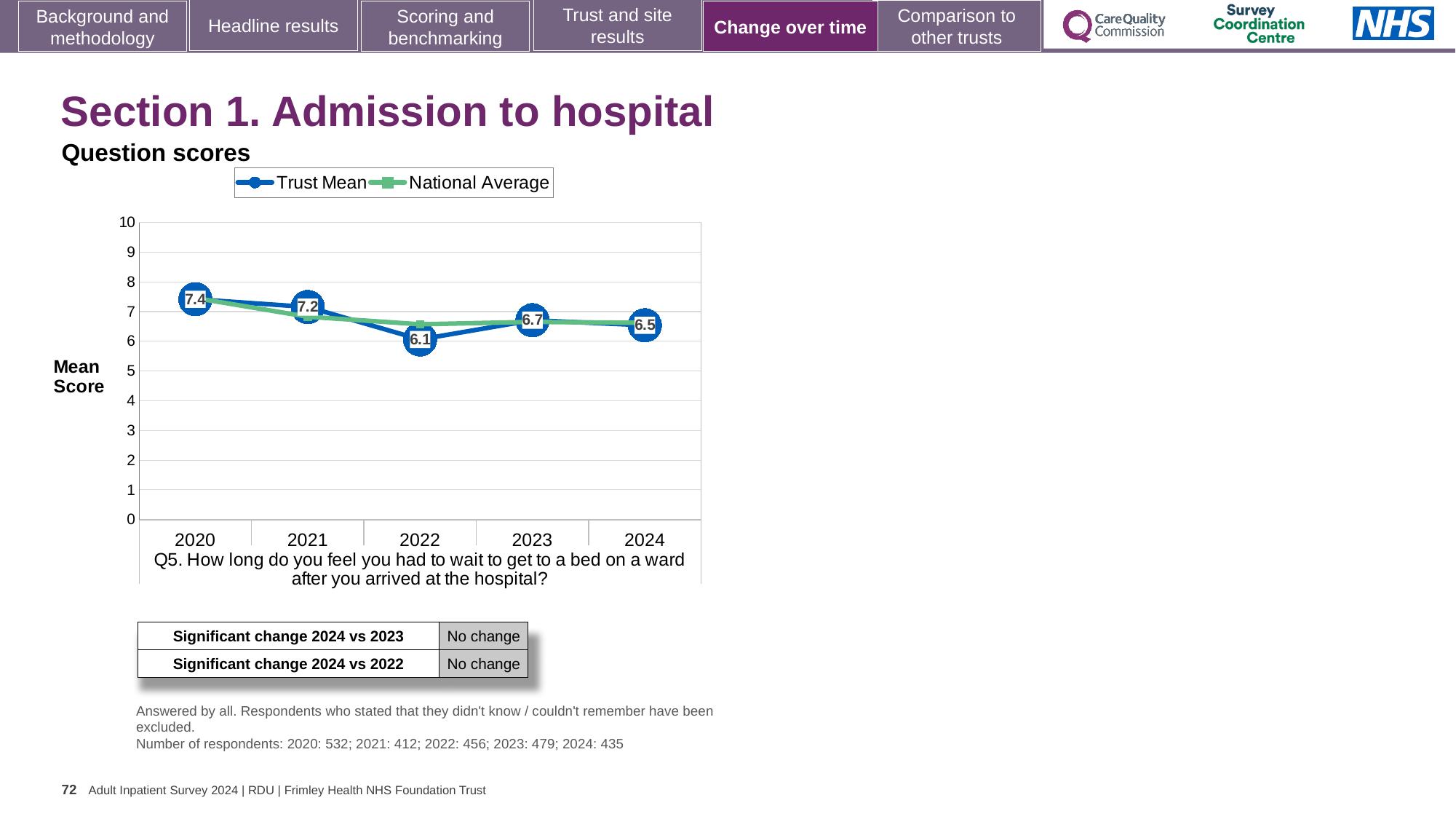
What kind of chart is shown on the slide? Line chart What is the difference between the Trust Mean scores for 2020 and 2022? 1.3 What is the Trust Mean score for 2024? 6.5 What is the Trust Mean score for 2020? 7.4 What is the Trust Mean score for 2022? 6.1 Does the Trust Mean score rise or fall between 2020 and 2024 overall? Fall How many years are plotted on the x axis? 5 Which year has the larger Trust Mean score, 2021 or 2023? 2021 In which year is the Trust Mean score lowest? 2022 Is the National Average value for 2022 greater or less than 7? less How many series does the legend list? 2 In which year is the Trust Mean score highest? 2020